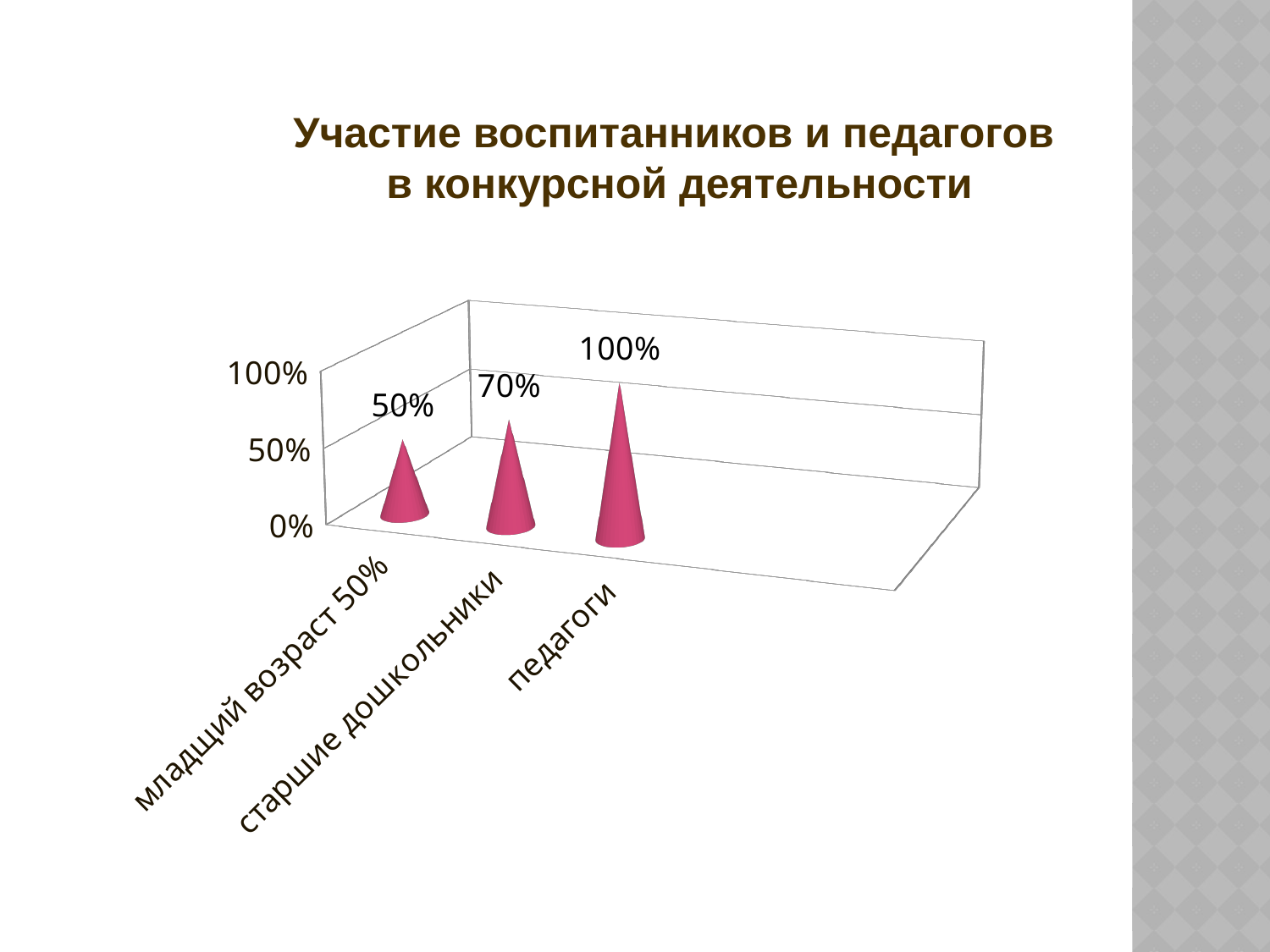
Which category has the lowest value? младщий возраст 50% What is the difference between the values for педагоги and старшие дошкольники? 30% What is the value for младший возраст 50%? 50% What is the value for старшие дошкольники? 70% Which category has the highest value? педагоги How many categories are shown on the chart? 3 Which is larger, the value for старшие дошкольники or the value for младший возраст 50%? старшие дошкольники Do the values rise or fall from left to right along the x axis? rise What kind of chart is shown on the slide? bar chart What is the difference between the values for старшие дошкольники and младший возраст 50%? 20% What is the value for педагоги? 100% What is the title of the slide? Участие воспитанников и педагогов в конкурсной деятельности